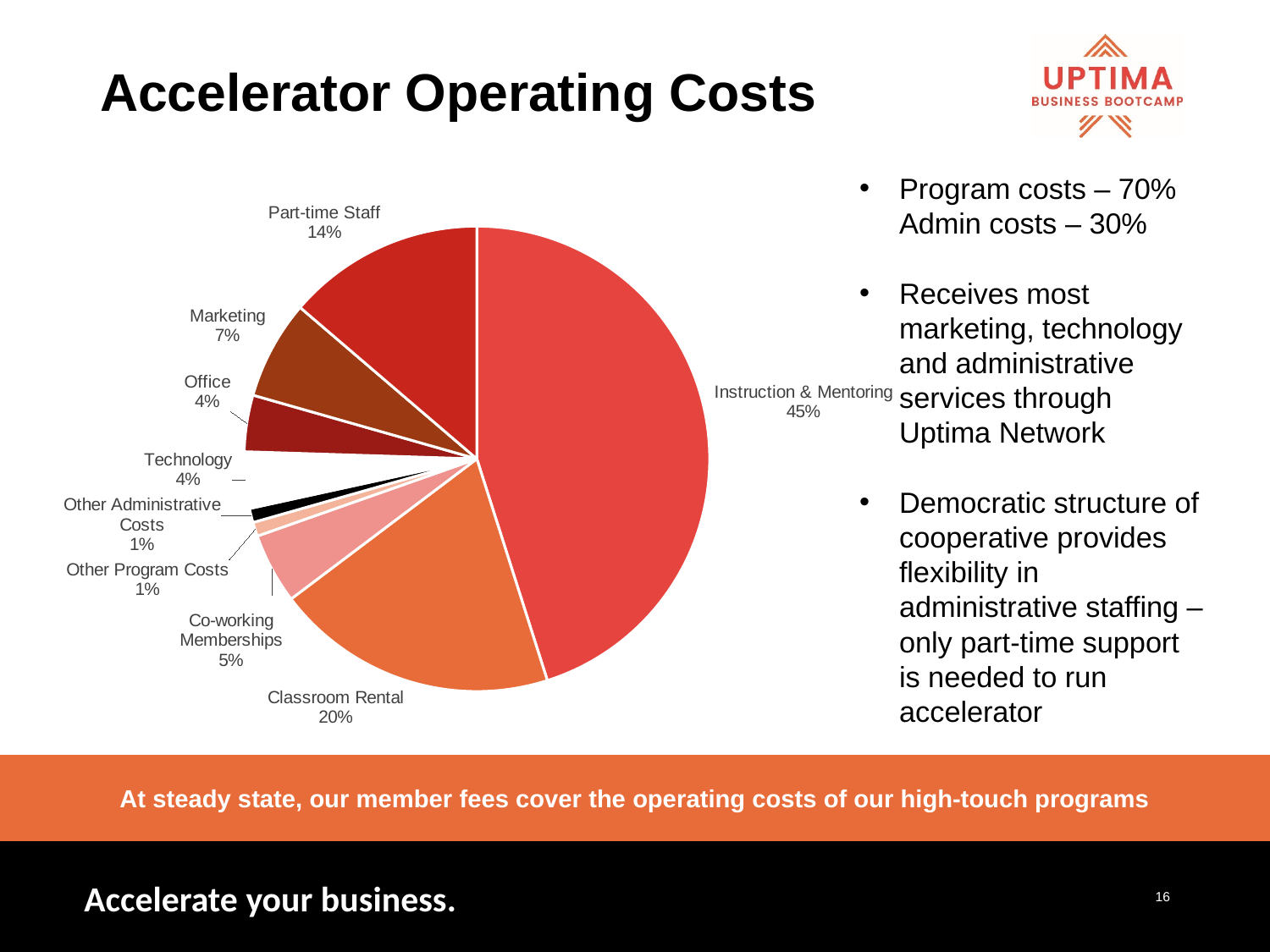
What is the value shown for Co-working Memberships? 5% What is the difference between the shares for Part-time Staff and Office? 10% What is the title of the slide containing the pie chart? Accelerator Operating Costs What is the value shown for Part-time Staff? 14% What kind of chart is shown on the slide? pie chart What is the difference between the shares for Instruction & Mentoring and Classroom Rental? 25% Which is larger, the share for Part-time Staff or the share for Marketing? Part-time Staff What is the value shown for Classroom Rental? 20% How many categories does the pie chart show? 9 What share of the pie does Instruction & Mentoring account for? 45% What is the value shown for Marketing? 7% Which category has the largest share of the pie chart? Instruction & Mentoring